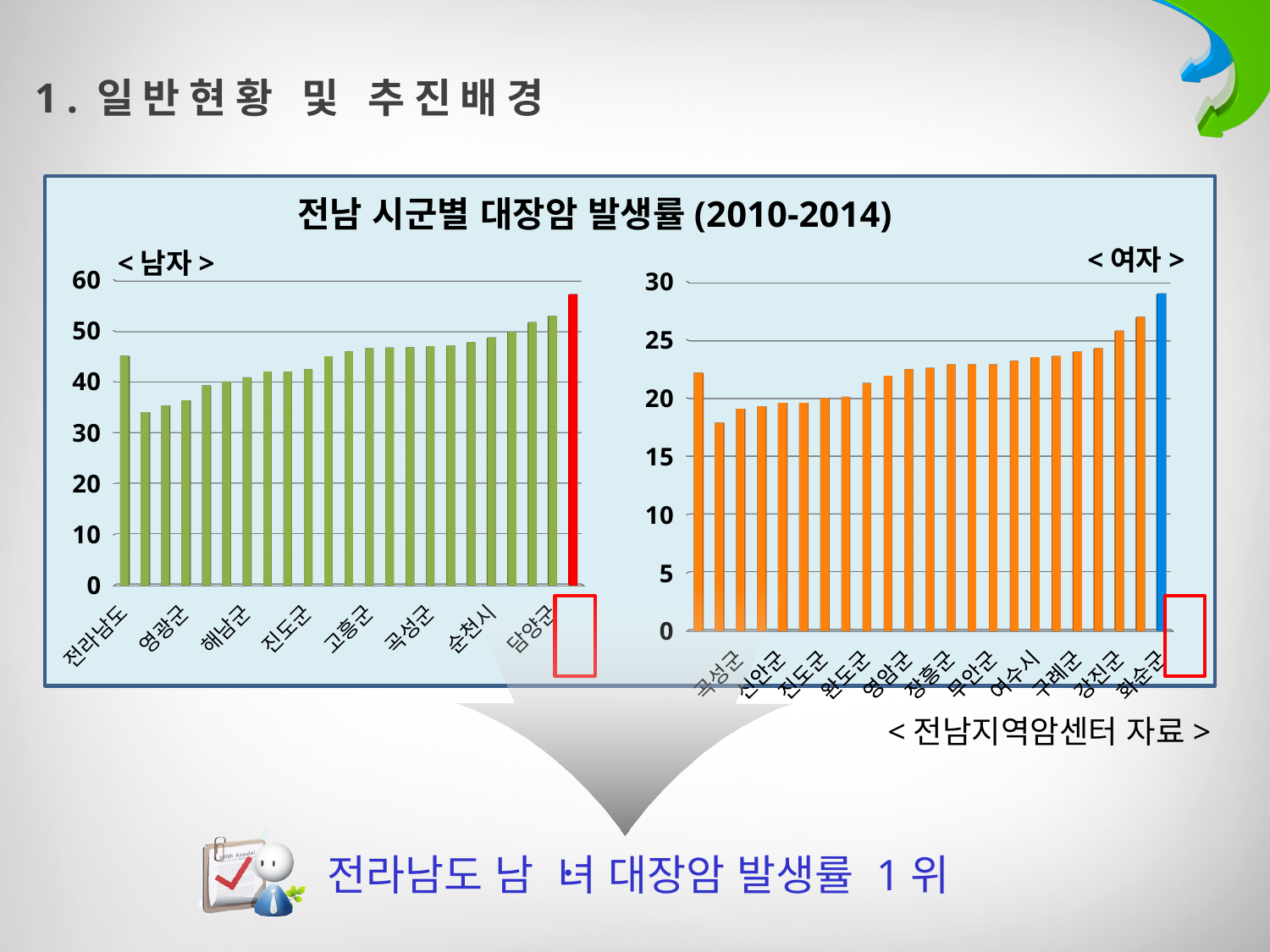
What is the title shown above the two charts? 전남 시군별 대장암 발생률 (2010-2014) In the 남자 chart, is the value for 담양군 greater or less than 40? greater In the 남자 chart, which is larger, the value for 전라남도 or the value for 영광군? 전라남도 In the 남자 chart, what colour is the tallest bar? red In the 여자 chart, is the value for 화순군 greater or less than 25? greater What kind of chart is the 여자 chart on the right? bar chart In the 여자 chart, do the bars generally rise or fall from left to right after the first bar? rise In the 남자 chart, is the value for 전라남도 greater or less than 40? greater What kind of chart is the 남자 chart on the left? bar chart